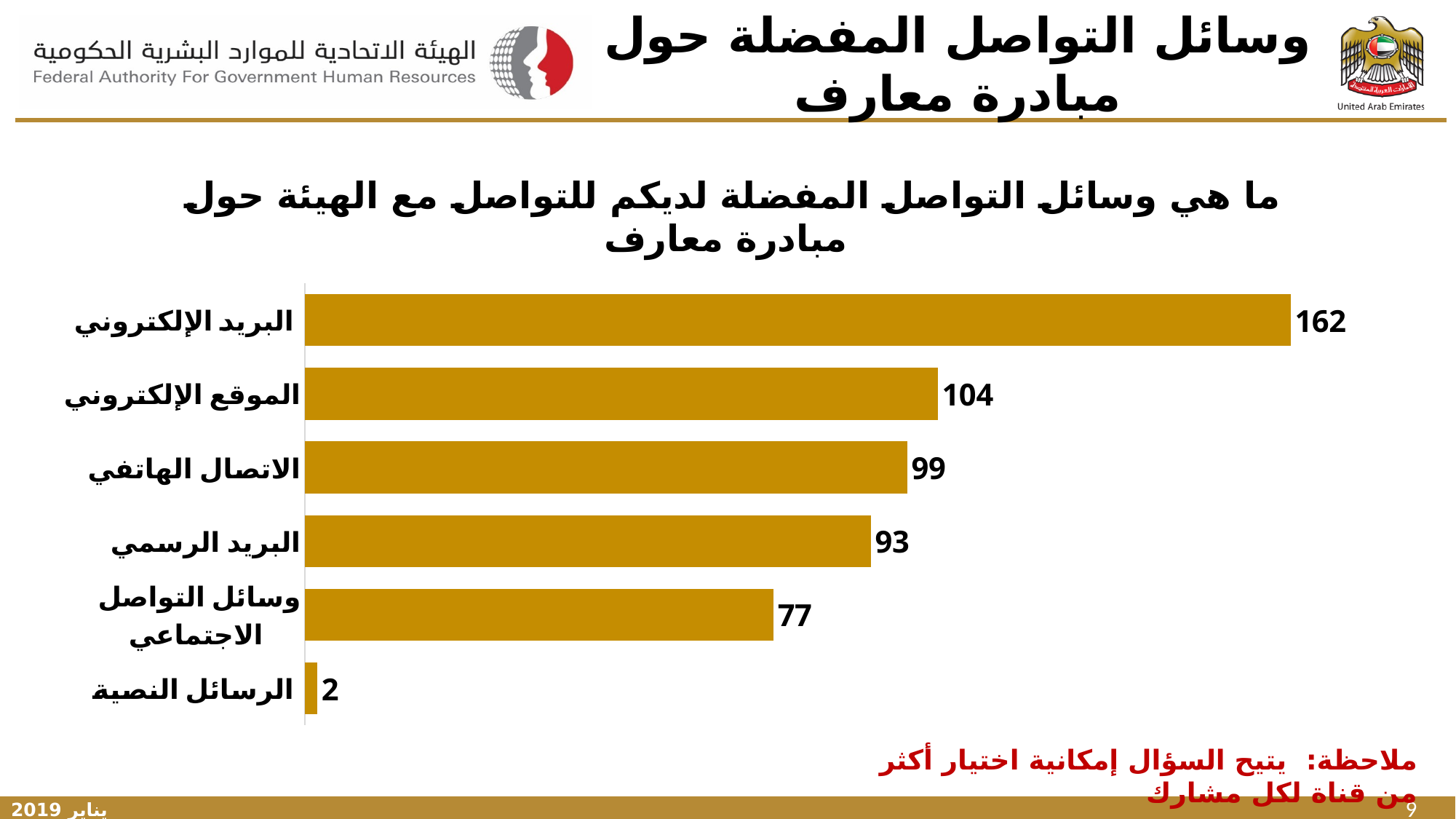
What is the difference between the values for البريد الإلكتروني and الموقع الإلكتروني? 58 What kind of chart is shown on the slide? bar chart What is the value for البريد الإلكتروني? 162 What is the value for الاتصال الهاتفي? 99 What colour are the bars in the chart? gold Which category has the highest value? البريد الإلكتروني Which category has the lowest value? الرسائل النصية What is the value for وسائل التواصل الاجتماعي? 77 How many categories are shown in the chart? 6 What is the value for الموقع الإلكتروني? 104 Which is larger, the value for الاتصال الهاتفي or the value for البريد الرسمي? الاتصال الهاتفي What is the difference between the values for البريد الرسمي and الرسائل النصية? 91